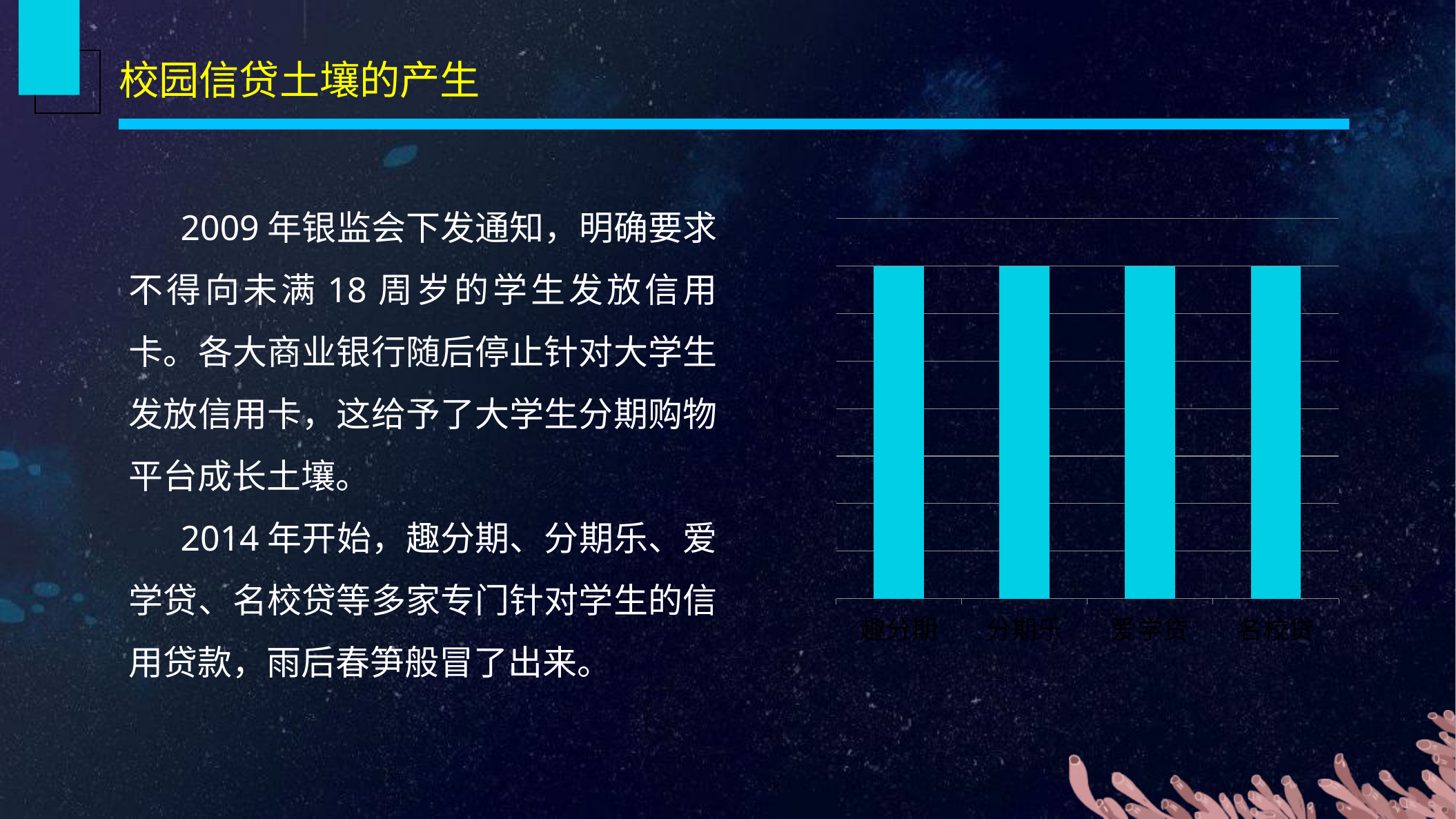
What is the label of the last (rightmost) bar in the chart? 名校贷 What is the label of the first (leftmost) bar in the chart? 趣分期 How many categories (bars) does the chart on the right show? 4 What kind of chart is shown on the right side of the slide? bar chart Do the bar heights rise, fall, or stay flat from left to right across the chart? stay flat